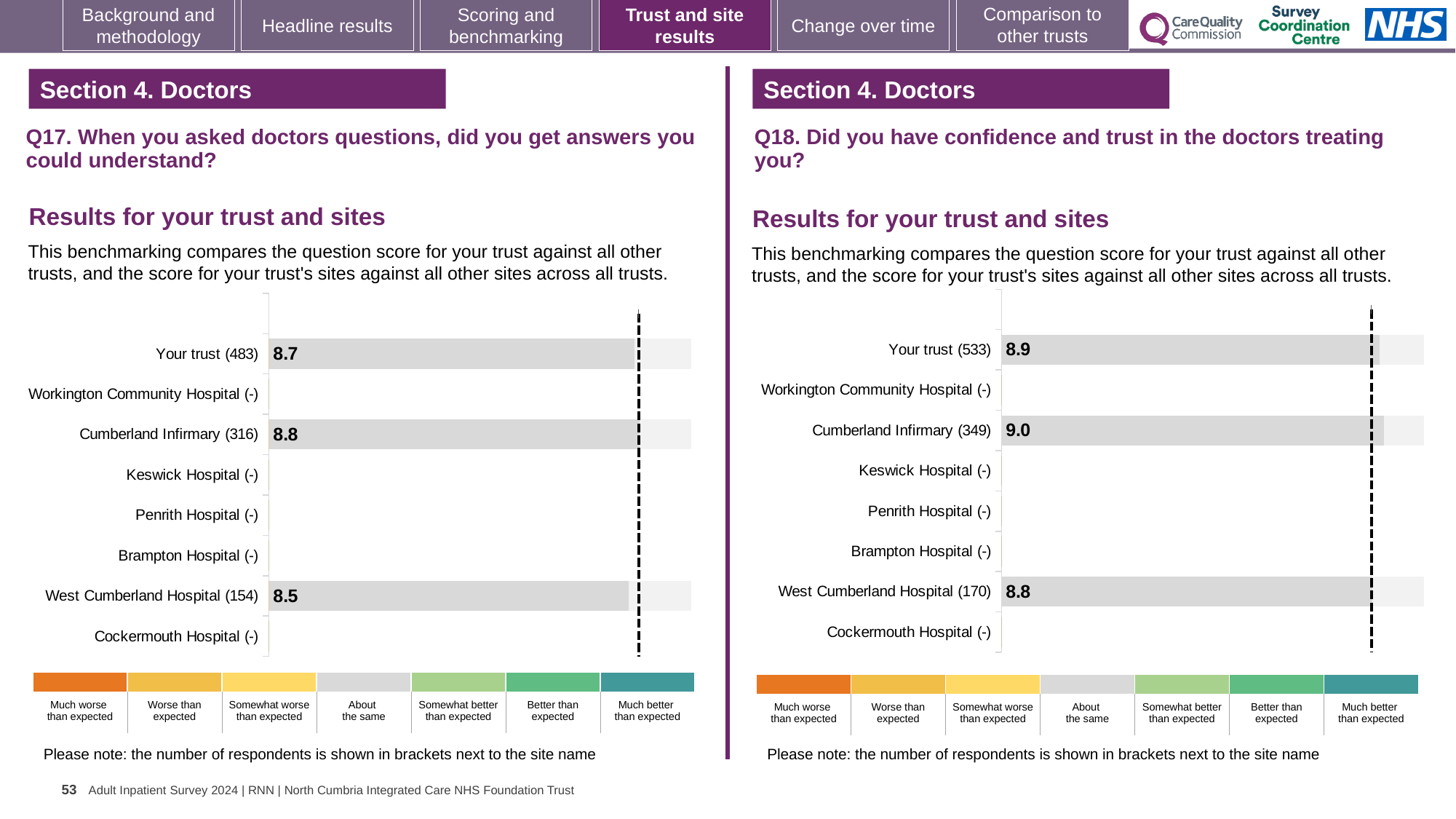
What kind of chart is the Q18 chart? Bar chart In the Q17 chart, what is the score for Cumberland Infirmary (316)? 8.8 In the Q17 chart, what is the score for Your trust (483)? 8.7 In the Q18 chart, which is larger: the score for Your trust (533) or the score for West Cumberland Hospital (170)? Your trust (533) In the Q18 chart, what is the score for West Cumberland Hospital (170)? 8.8 In the Q17 chart, what is the difference between the scores for Cumberland Infirmary (316) and West Cumberland Hospital (154)? 0.3 In the Q18 chart, what is the score for Your trust (533)? 8.9 In the Q17 chart, which site with a plotted score has the lowest score? West Cumberland Hospital (154) In the Q18 chart, which site with a plotted score has the highest score? Cumberland Infirmary (349) How many categories (rows) are listed on the y axis of the Q17 chart? 8 In the Q17 chart, what is the score for West Cumberland Hospital (154)? 8.5 In the Q18 chart, what is the score for Cumberland Infirmary (349)? 9.0